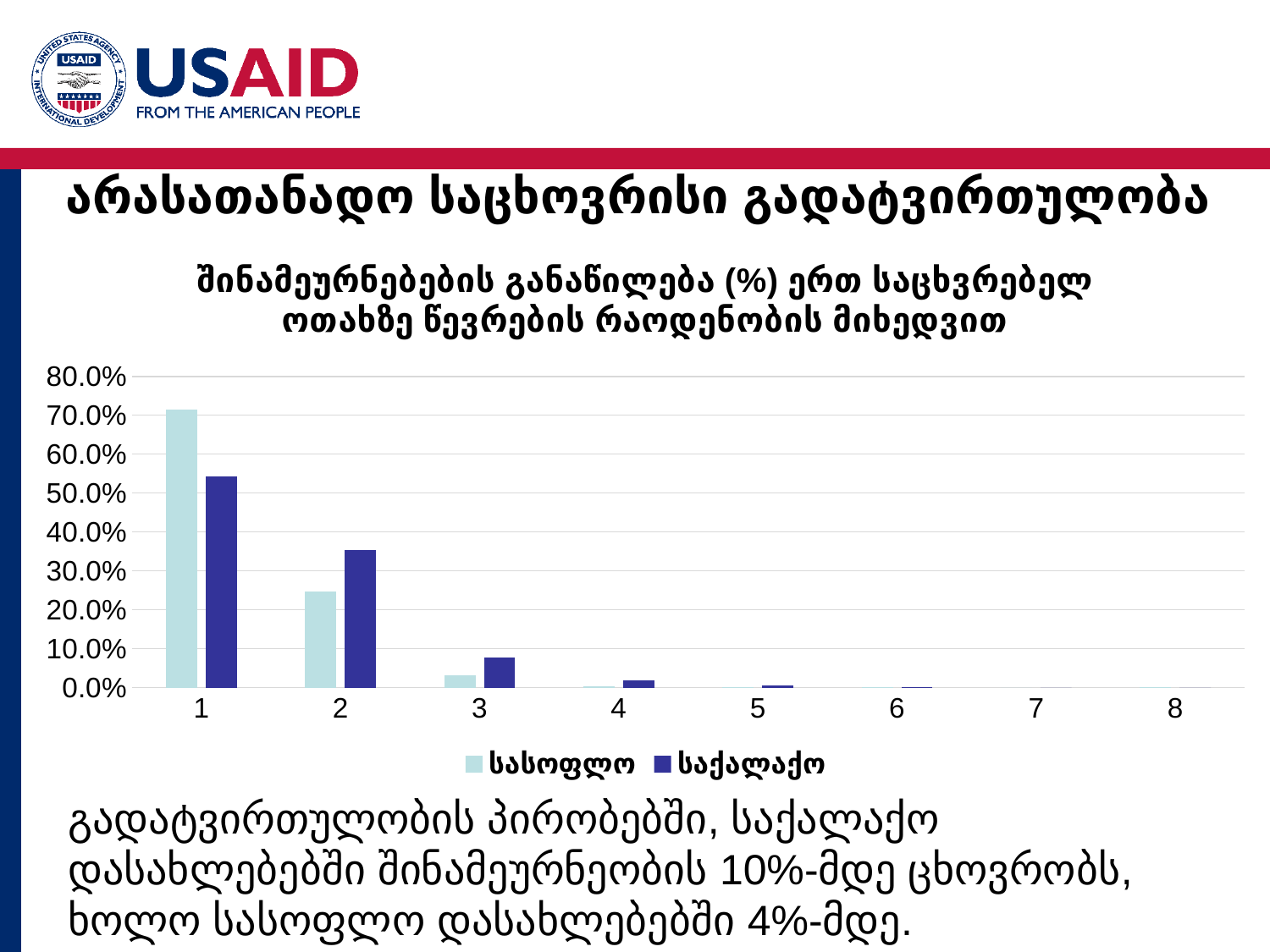
How many series does the chart legend list? 2 What kind of chart is shown on the slide? bar chart Which category has the highest value for the საქალაქო series? 1 Is the სასოფლო value for category 1 greater or less than 70.0%? greater Is the სასოფლო value for category 2 greater or less than 30.0%? less Is the საქალაქო value for category 2 greater or less than 30.0%? greater Which category has the highest value for the სასოფლო series? 1 Do the values for the საქალაქო series rise or fall as the category number increases from 1 to 8? fall For category 2, which series has the larger value, სასოფლო or საქალაქო? საქალაქო For category 1, which series has the larger value, სასოფლო or საქალაქო? სასოფლო How many categories are shown along the x axis of the chart? 8